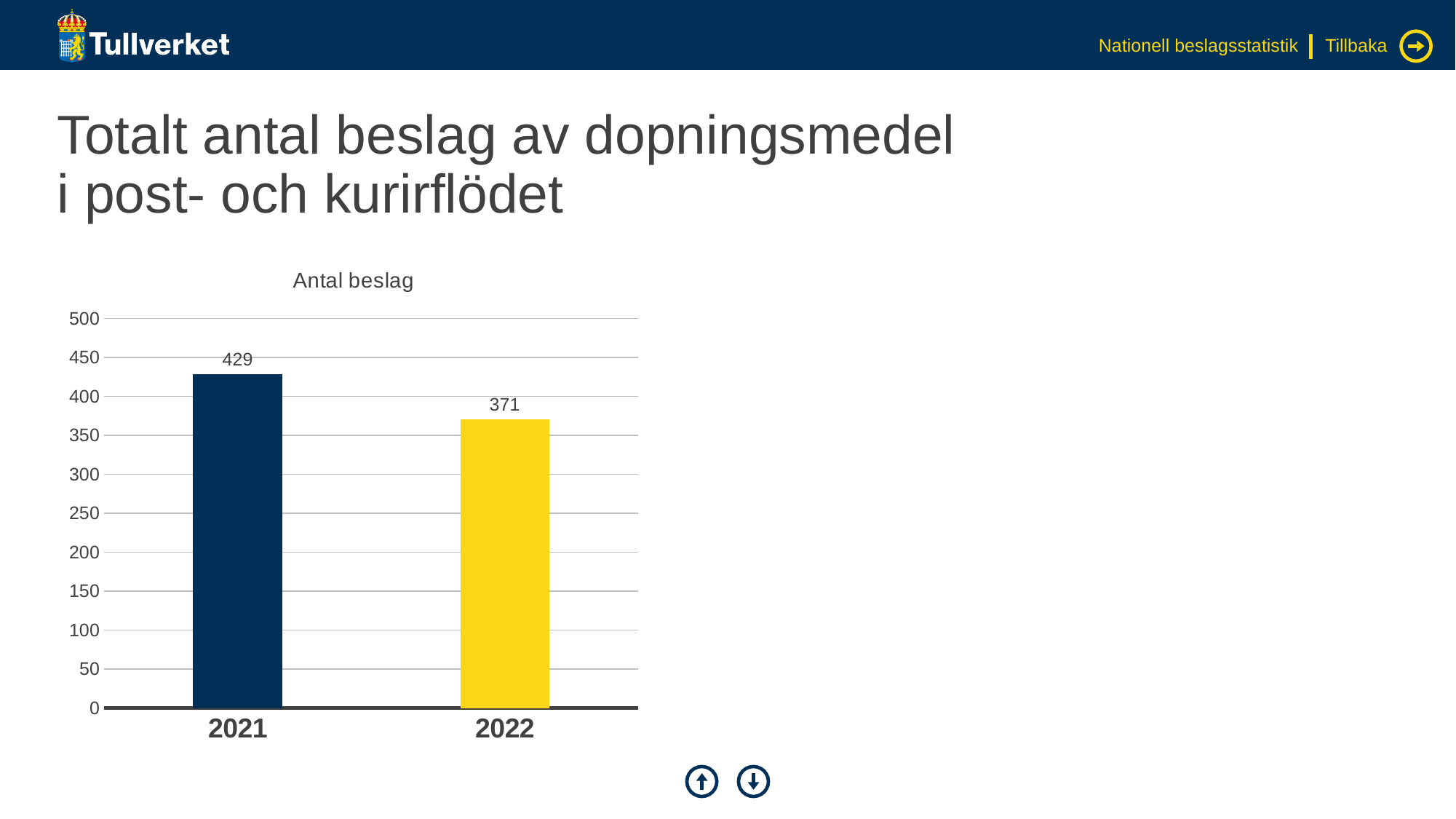
What is the difference between the values for 2021 and 2022? 58 What kind of chart is shown on the slide? bar chart Is the value for 2022 greater or less than 400? less How many categories are shown on the x axis? 2 Which year has the lowest number of seizures? 2022 What is the value for 2022? 371 What is the title of the chart? Antal beslag What is the value for 2021? 429 Which is larger, the value for 2021 or the value for 2022? 2021 Is the value for 2021 greater or less than 400? greater Do the values rise or fall from 2021 to 2022? fall Which year has the highest number of seizures? 2021